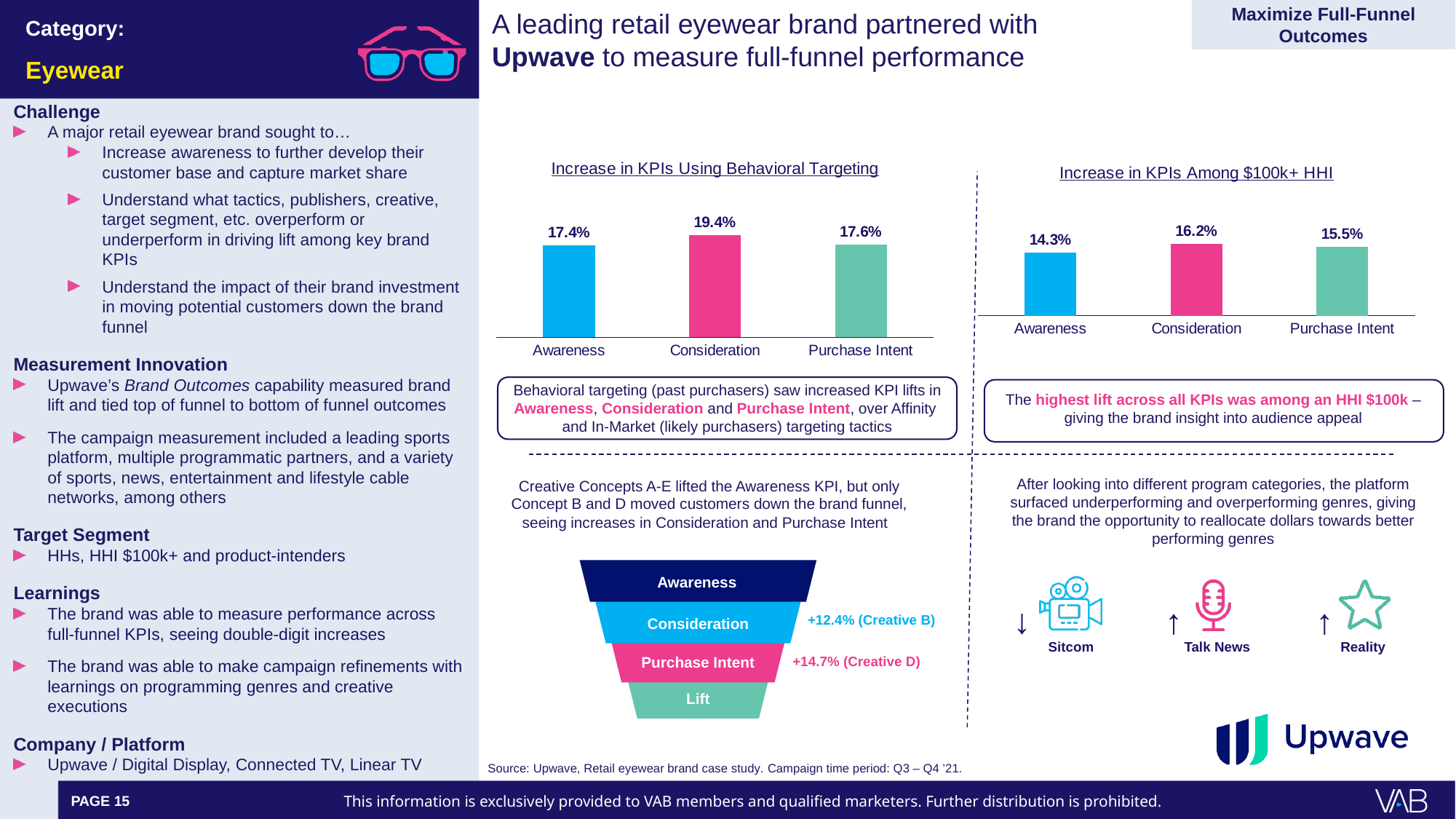
Which is larger: Purchase Intent in the 'Increase in KPIs Using Behavioral Targeting' chart or Purchase Intent in the 'Increase in KPIs Among $100k+ HHI' chart? Behavioral Targeting (17.6%) In the 'Increase in KPIs Using Behavioral Targeting' chart, what is the value for Consideration? 19.4% In the 'Increase in KPIs Among $100k+ HHI' chart, what colour is the Consideration bar? Pink How many categories are shown in the 'Increase in KPIs Among $100k+ HHI' chart? 3 In the 'Increase in KPIs Using Behavioral Targeting' chart, which category has the highest value? Consideration In the 'Increase in KPIs Among $100k+ HHI' chart, what is the difference between Consideration and Purchase Intent? 0.7% In the 'Increase in KPIs Using Behavioral Targeting' chart, what is the difference between Consideration and Awareness? 2.0% What type of chart is 'Increase in KPIs Using Behavioral Targeting'? Bar chart In the 'Increase in KPIs Among $100k+ HHI' chart, what is the value for Awareness? 14.3% In the 'Increase in KPIs Among $100k+ HHI' chart, which category has the lowest value? Awareness In the 'Increase in KPIs Among $100k+ HHI' chart, what is the value for Purchase Intent? 15.5% In the 'Increase in KPIs Using Behavioral Targeting' chart, what is the value for Awareness? 17.4%